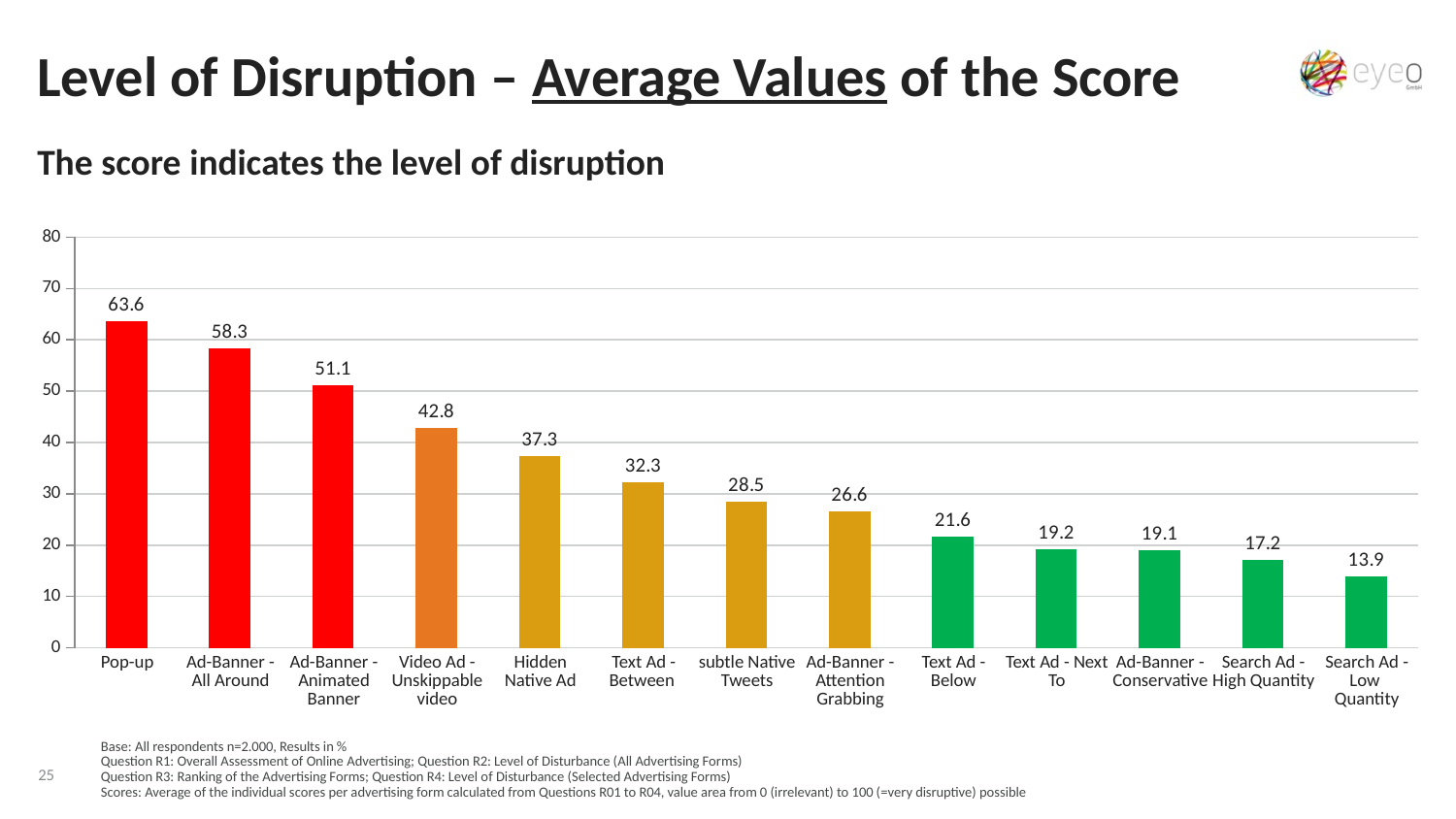
What is the value shown for Ad-Banner - Attention Grabbing? 26.6 What is the value shown for Video Ad - Unskippable video? 42.8 Which advertising form has the highest disruption score? Pop-up Do the values rise or fall from left to right along the x axis? Fall Which has a higher score, Hidden Native Ad or Text Ad - Between? Hidden Native Ad What is the value shown for Search Ad - Low Quantity? 13.9 What is the difference between the scores for Pop-up and Search Ad - Low Quantity? 49.7 What kind of chart is shown on the slide? Bar chart Which advertising form has the lowest disruption score? Search Ad - Low Quantity What is the difference between the scores for Ad-Banner - All Around and Ad-Banner - Animated Banner? 7.2 How many advertising forms are shown on the chart? 13 What is the average disruption score for Pop-up? 63.6